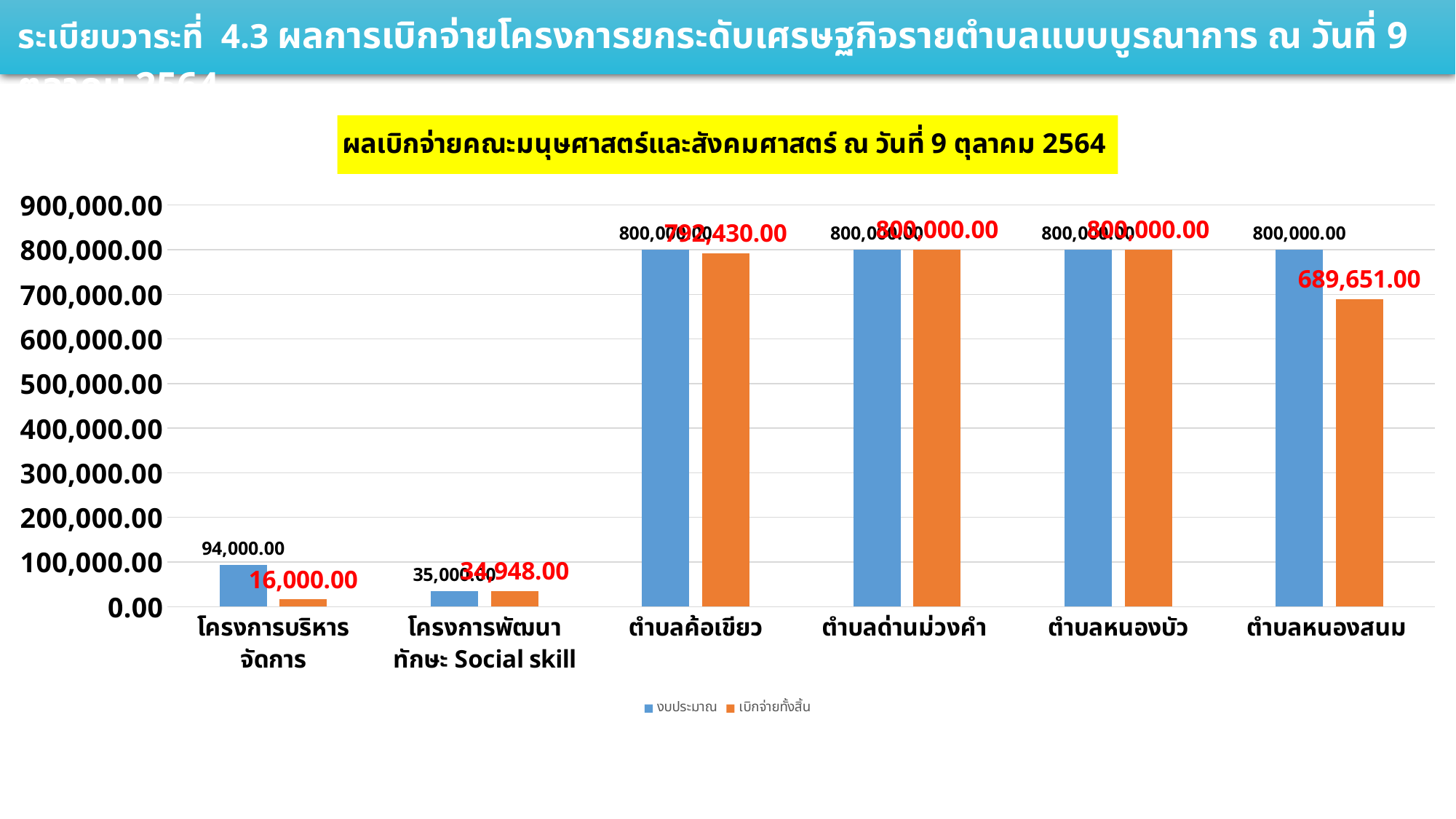
How many series does the chart legend list? 2 How many categories are shown on the x axis of the chart? 6 What is the เบิกจ่ายทั้งสิ้น value for ตำบลหนองสนม? 689,651.00 What is the งบประมาณ value for โครงการพัฒนาทักษะ Social skill? 35,000.00 What is the เบิกจ่ายทั้งสิ้น value for ตำบลค้อเขียว? 792,430.00 What is the งบประมาณ value for โครงการบริหารจัดการ? 94,000.00 Which is larger for ตำบลค้อเขียว, the งบประมาณ value or the เบิกจ่ายทั้งสิ้น value? งบประมาณ What type of chart is shown on the slide? bar chart What is the เบิกจ่ายทั้งสิ้น value for โครงการบริหารจัดการ? 16,000.00 What is the difference between the งบประมาณ and เบิกจ่ายทั้งสิ้น values for ตำบลหนองสนม? 110,349.00 Which category has the lowest งบประมาณ value? โครงการพัฒนาทักษะ Social skill What is the title of the chart? ผลเบิกจ่ายคณะมนุษศาสตร์และสังคมศาสตร์ ณ วันที่ 9 ตุลาคม 2564